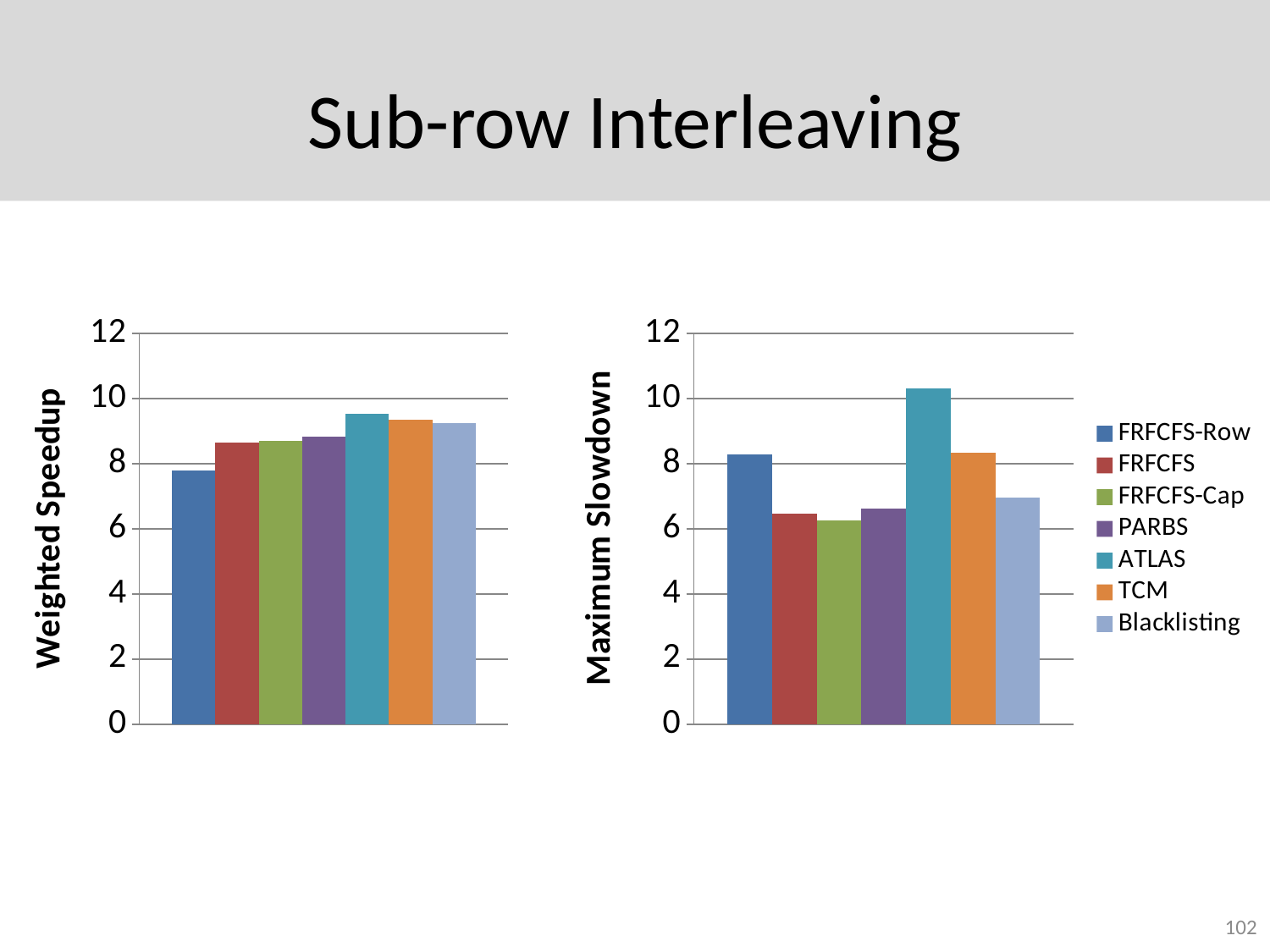
In the Maximum Slowdown chart, is the value for ATLAS greater or less than 10? greater What kind of chart is the Weighted Speedup chart on the left? bar chart In the Weighted Speedup chart, which series has the lowest value? FRFCFS-Row In the Weighted Speedup chart, is the value for FRFCFS-Row greater or less than 8? less What is the y-axis title of the chart on the right? Maximum Slowdown In the Maximum Slowdown chart, which series has the highest value? ATLAS How many series does the legend list? 7 In the Weighted Speedup chart, which is larger, ATLAS or FRFCFS-Row? ATLAS In the Maximum Slowdown chart, which is larger, FRFCFS-Row or Blacklisting? FRFCFS-Row In the Weighted Speedup chart, which series has the highest value? ATLAS How many bars are plotted in the Maximum Slowdown chart? 7 In the Maximum Slowdown chart, is the value for Blacklisting greater or less than 8? less